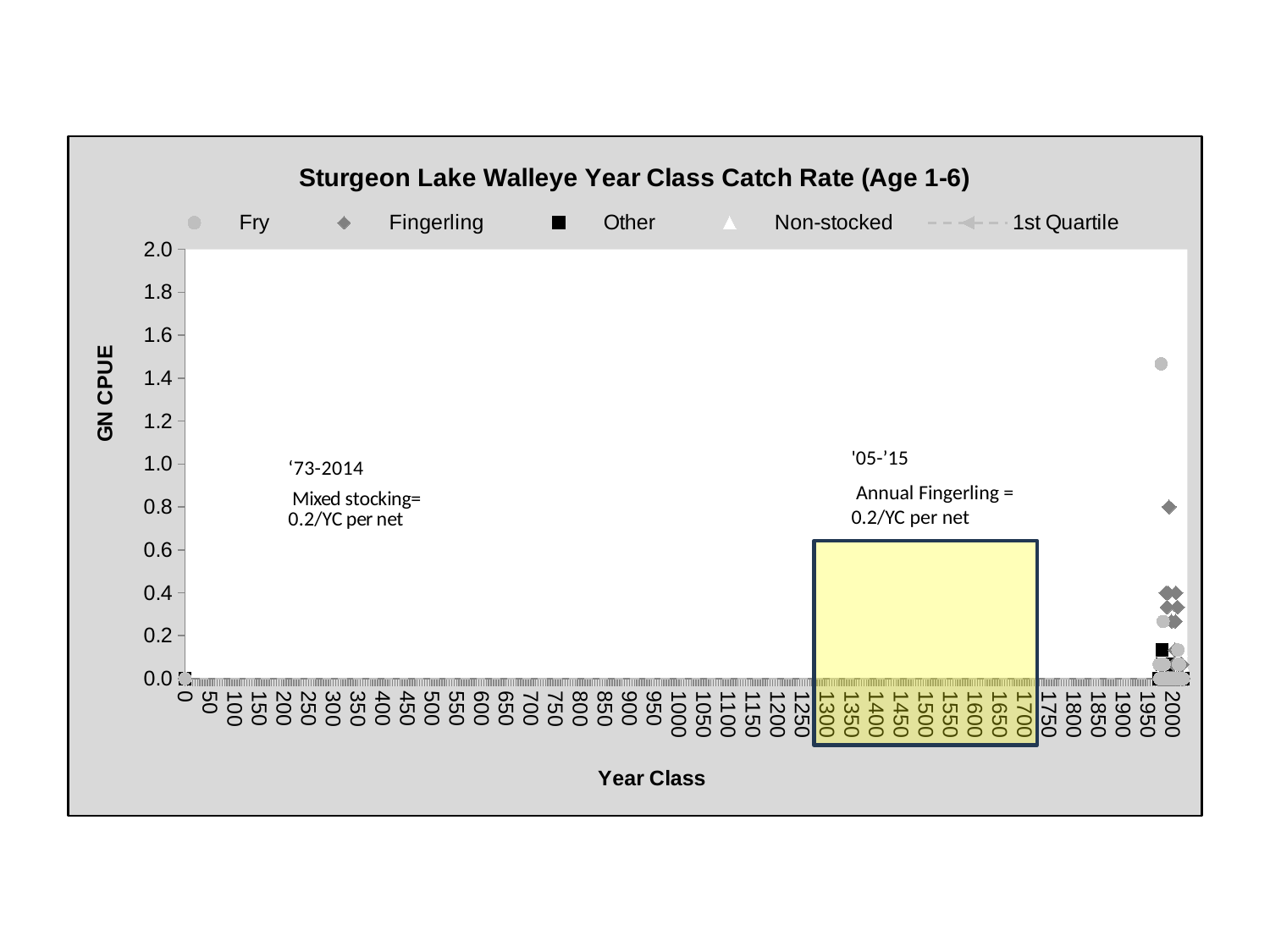
Is the highest Fingerling point greater or less than 1.0 on the GN CPUE axis? less Which series contains the highest plotted point on the chart? Fry Is the highest Fry point greater or less than 1.2 on the GN CPUE axis? greater How many series does the legend list? 5 Is the highest Other (black square) point greater or less than 0.4 on the GN CPUE axis? less What kind of chart is shown on the slide? Scatter chart What is the label of the vertical axis? GN CPUE What is the maximum value shown on the GN CPUE axis? 2.0 Is the highest Fry point greater or less than the highest Fingerling point? greater What is the title of the chart? Sturgeon Lake Walleye Year Class Catch Rate (Age 1-6)